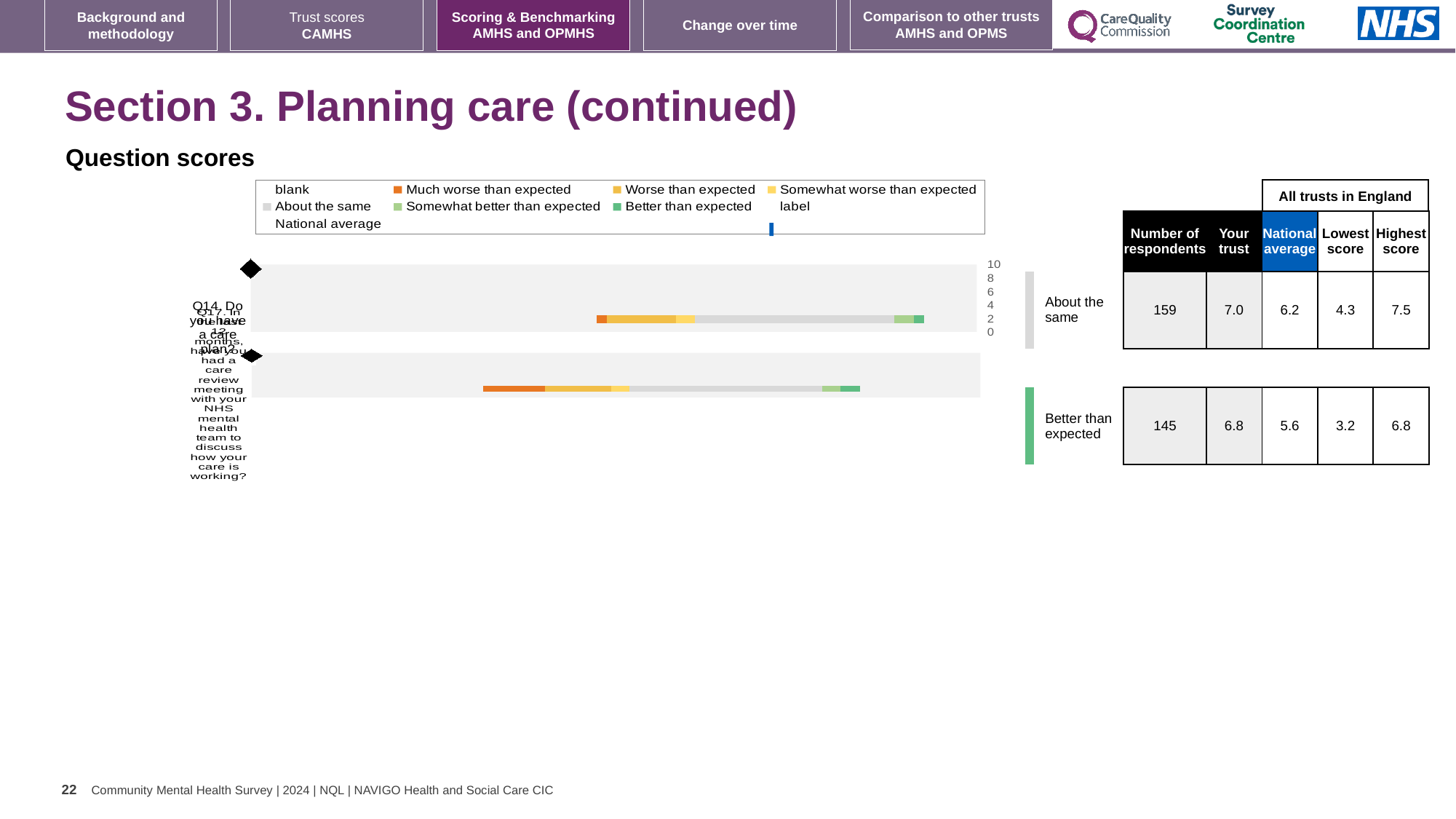
Is the trust's score for Q17 greater or less than the national average for Q17? greater What kind of chart is used to show the question scores? Bar chart How many respondents answered Q14? 159 Which question had more respondents, Q14 or Q17? Q14 What is the highest score among all trusts in England for Q17? 6.8 What is the lowest score among all trusts in England for Q14? 4.3 What benchmark category is shown for Q17? Better than expected How many questions are plotted in the chart? 2 What is the difference between the highest and lowest scores for Q17? 3.6 By how much does the trust's score for Q14 exceed the national average? 0.8 What is the national average score for Q17 (care review meeting in the last 12 months)? 5.6 What is the 'Your trust' score for Q14 (Do you have a care plan?)? 7.0